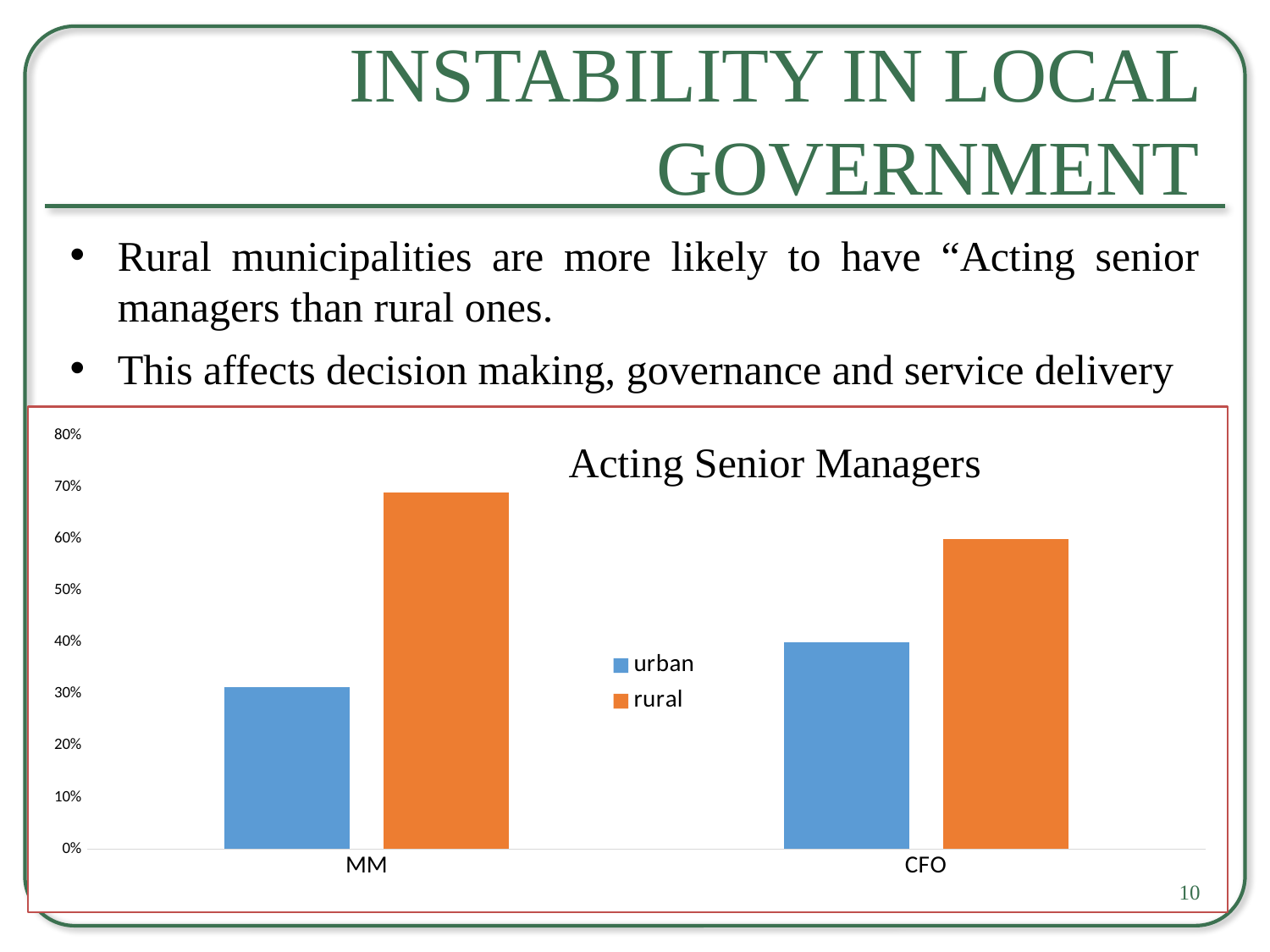
Is the rural value for CFO greater or less than 50%? greater What kind of chart is shown on the slide? bar chart Is the rural value for MM greater or less than 60%? greater How many categories are shown on the x axis of the chart? 2 Which bar in the chart is the highest? rural for MM Is the urban value for MM greater or less than 40%? less Which bar in the chart is the lowest? urban for MM What is the title of the chart? Acting Senior Managers For MM, which is larger, the urban value or the rural value? rural How many series does the chart's legend list? 2 Which series is shown in orange in the chart? rural